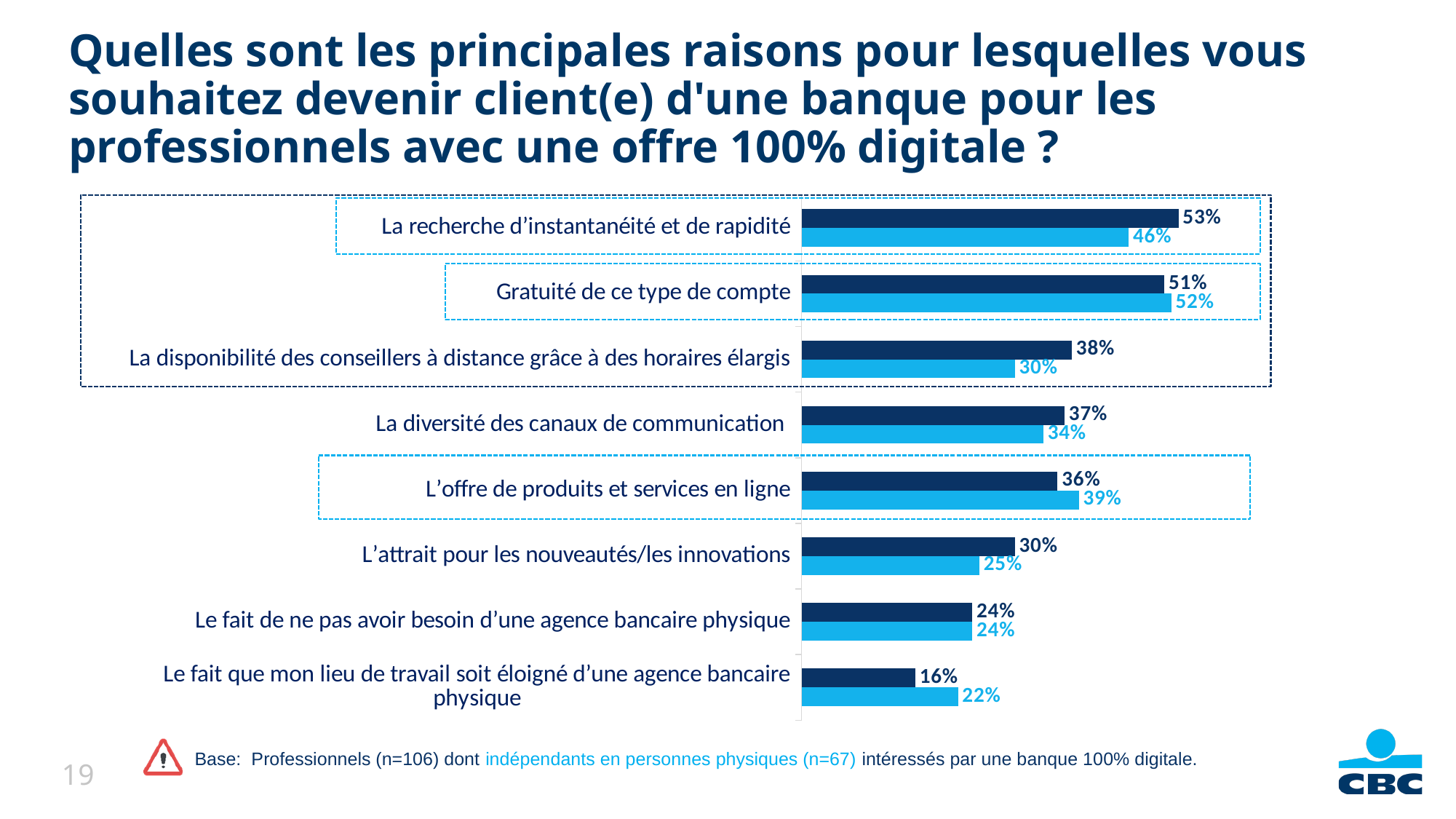
What type of chart is shown on the slide? bar chart Which category has the highest dark blue bar value? La recherche d’instantanéité et de rapidité What is the value of the light blue bar for "Gratuité de ce type de compte"? 52% For "L’offre de produits et services en ligne", which bar is larger, the dark blue or the light blue? light blue What is the value of the dark blue bar for "La recherche d’instantanéité et de rapidité"? 53% What is the difference between the dark blue and light blue values for "La disponibilité des conseillers à distance grâce à des horaires élargis"? 8% Which category has the lowest light blue bar value? Le fait que mon lieu de travail soit éloigné d’une agence bancaire physique What is the value of the light blue bar for "La disponibilité des conseillers à distance grâce à des horaires élargis"? 30% What is the difference between the dark blue values for "La recherche d’instantanéité et de rapidité" and "L’attrait pour les nouveautés/les innovations"? 23% What is the value of the dark blue bar for "Le fait que mon lieu de travail soit éloigné d’une agence bancaire physique"? 16% For "Le fait de ne pas avoir besoin d’une agence bancaire physique", what value do both bars show? 24% How many categories are shown in the chart? 8